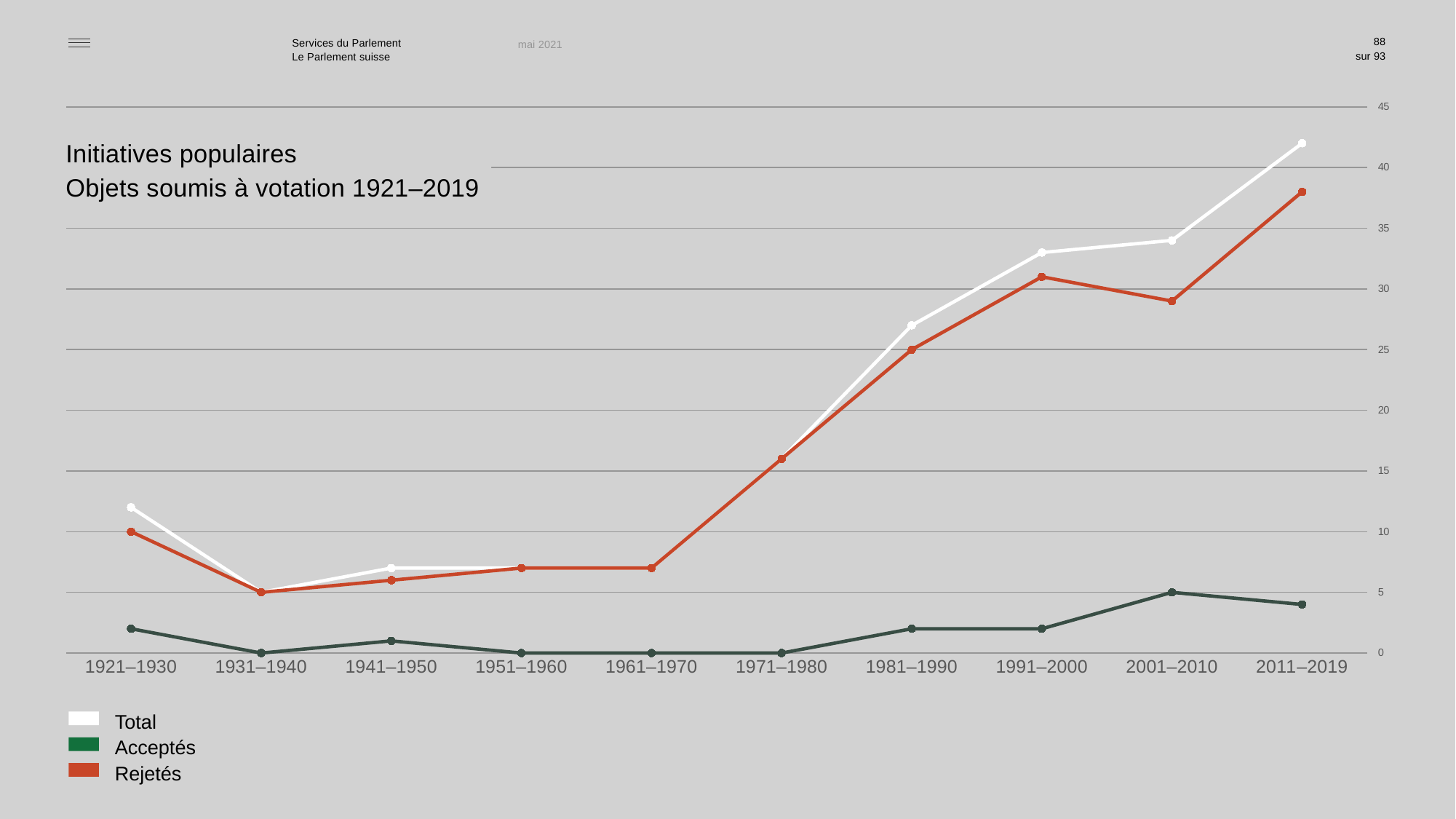
How many series does the legend list? 3 Is the value of Rejetés for 2001–2010 greater or less than 30? less What is the value of Rejetés for 1921–1930? 10 What is the value of Rejetés for 1981–1990? 25 What kind of chart is shown on the slide? line chart Is the value of Total for 2011–2019 greater or less than 40? greater Does the Total series rise or fall from 1971–1980 to 2011–2019? rise What is the value of Acceptés for 2001–2010? 5 Which series has the lowest values across the chart? Acceptés Which period has the highest Total value? 2011–2019 What is the value of Acceptés for 1961–1970? 0 How many decade periods are shown on the x axis? 10